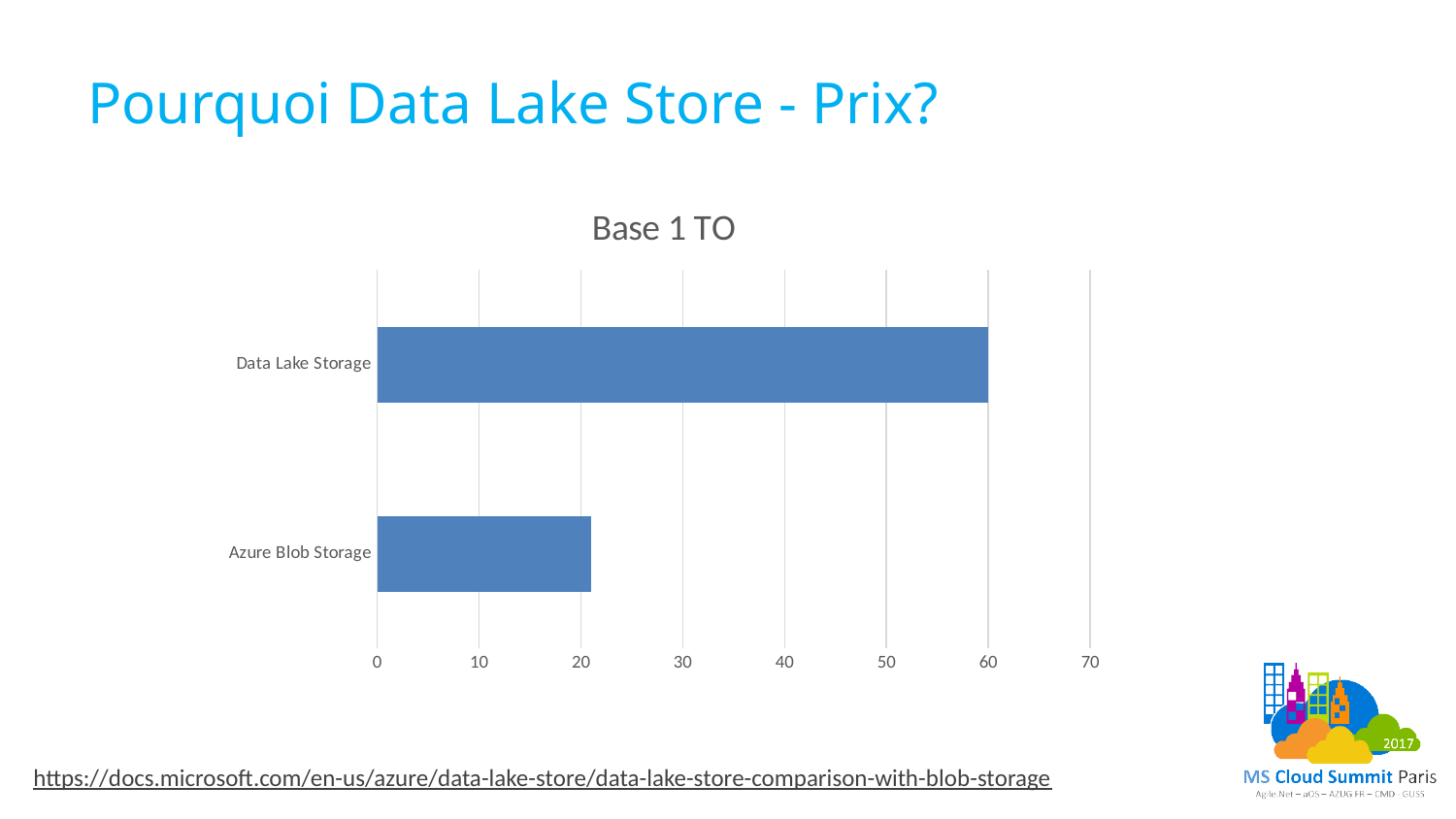
Is the value for Azure Blob Storage greater or less than 30? less Which category has the lowest value? Azure Blob Storage What kind of chart is shown on the slide? bar chart Which category has the highest value? Data Lake Storage What is the value for Data Lake Storage? 60 Which is larger, the value for Data Lake Storage or the value for Azure Blob Storage? Data Lake Storage What is the title of the chart? Base 1 TO Is the value for Data Lake Storage greater or less than 50? greater Is the value for Azure Blob Storage greater or less than 10? greater What is the highest value shown on the horizontal axis? 70 How many categories are plotted in the chart? 2